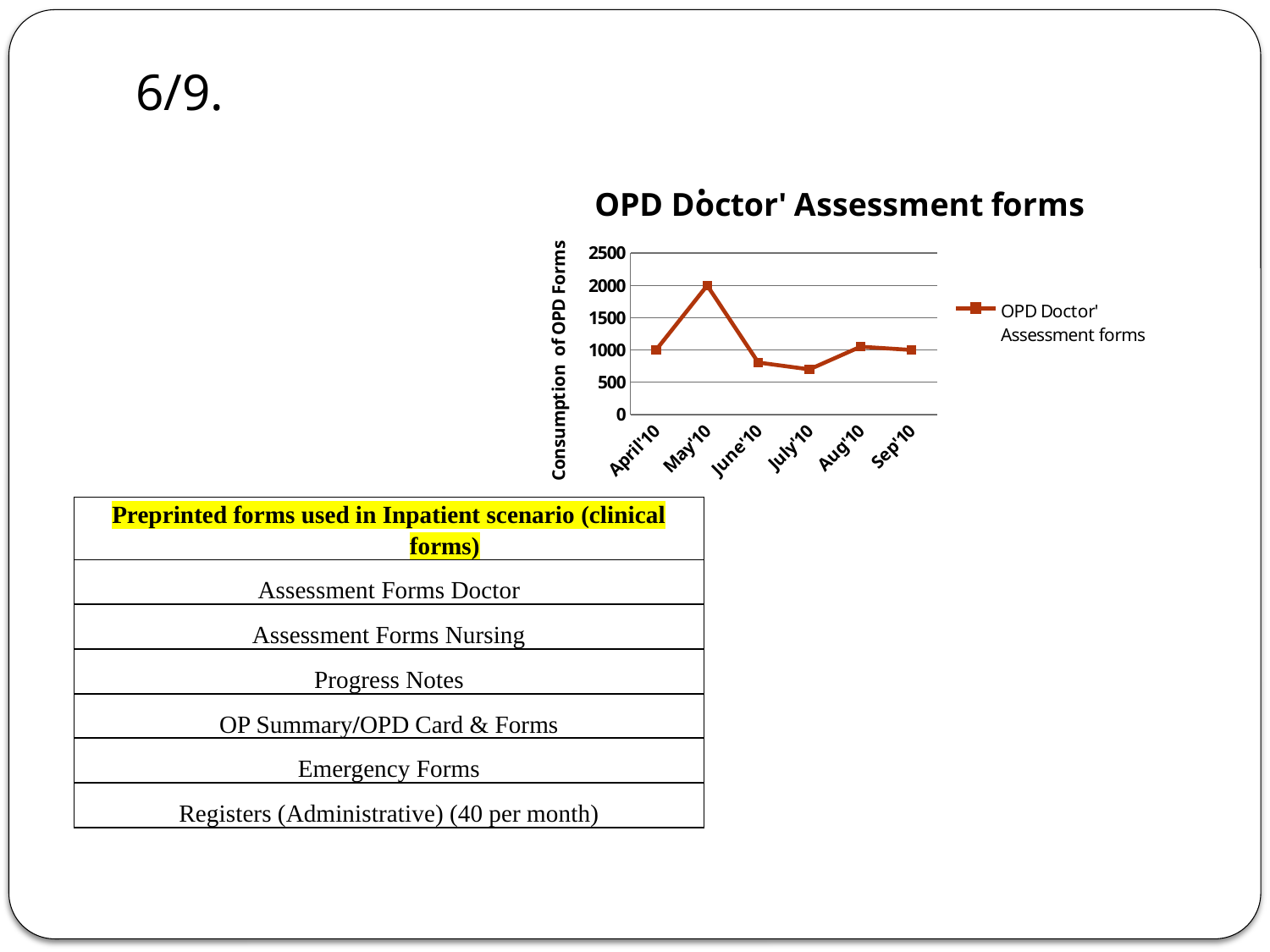
What is the title of the chart? OPD Doctor' Assessment forms Which month has the highest consumption of OPD Doctor' Assessment forms? May'10 How many months are plotted on the x axis of the chart? 6 Is the value for June'10 greater or less than 1000? less Which is larger, the value for May'10 or the value for Aug'10? May'10 How many series does the chart legend list? 1 Is the value for July'10 greater or less than 500? greater What kind of chart is shown on the slide? line chart Which month has the lowest consumption of OPD Doctor' Assessment forms? July'10 What is the label of the y axis of the chart? Consumption of OPD Forms Is the value for May'10 greater or less than 1500? greater What is the consumption of OPD Doctor' Assessment forms in May'10? 2000